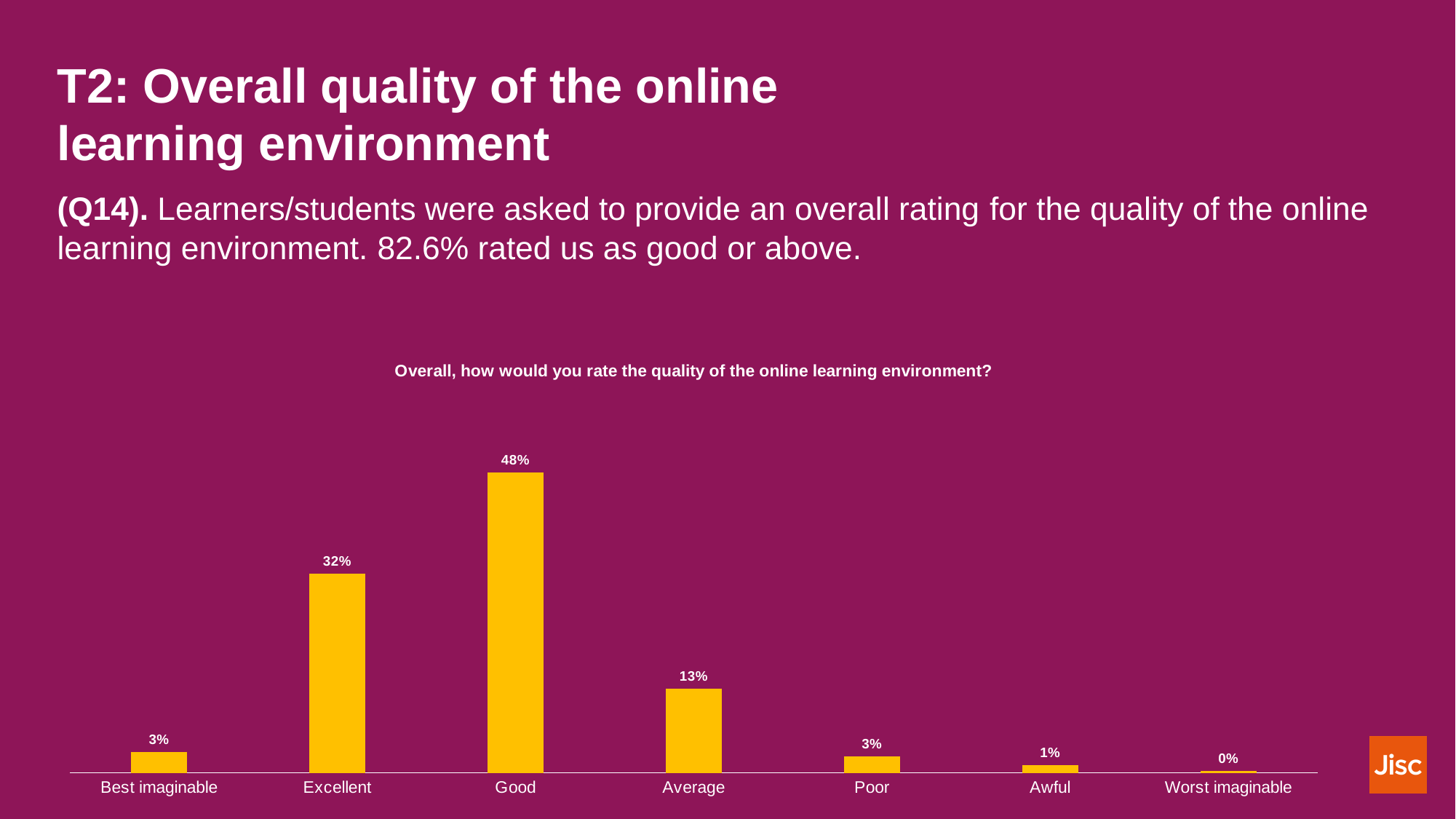
What percentage of respondents rated the online learning environment as Average? 13% Which rating category has the highest percentage? Good Which has a higher percentage, Average or Poor? Average How many rating categories are shown on the x axis? 7 What percentage of respondents rated the online learning environment as Good? 48% What colour are the bars in the chart? Yellow What is the title of the chart? Overall, how would you rate the quality of the online learning environment? What is the difference in percentage points between the Good and Excellent ratings? 16% What percentage of respondents rated the online learning environment as Excellent? 32% What percentage of respondents rated the online learning environment as Awful? 1% Which rating category has the lowest percentage? Worst imaginable What type of chart is shown on the slide? Bar chart